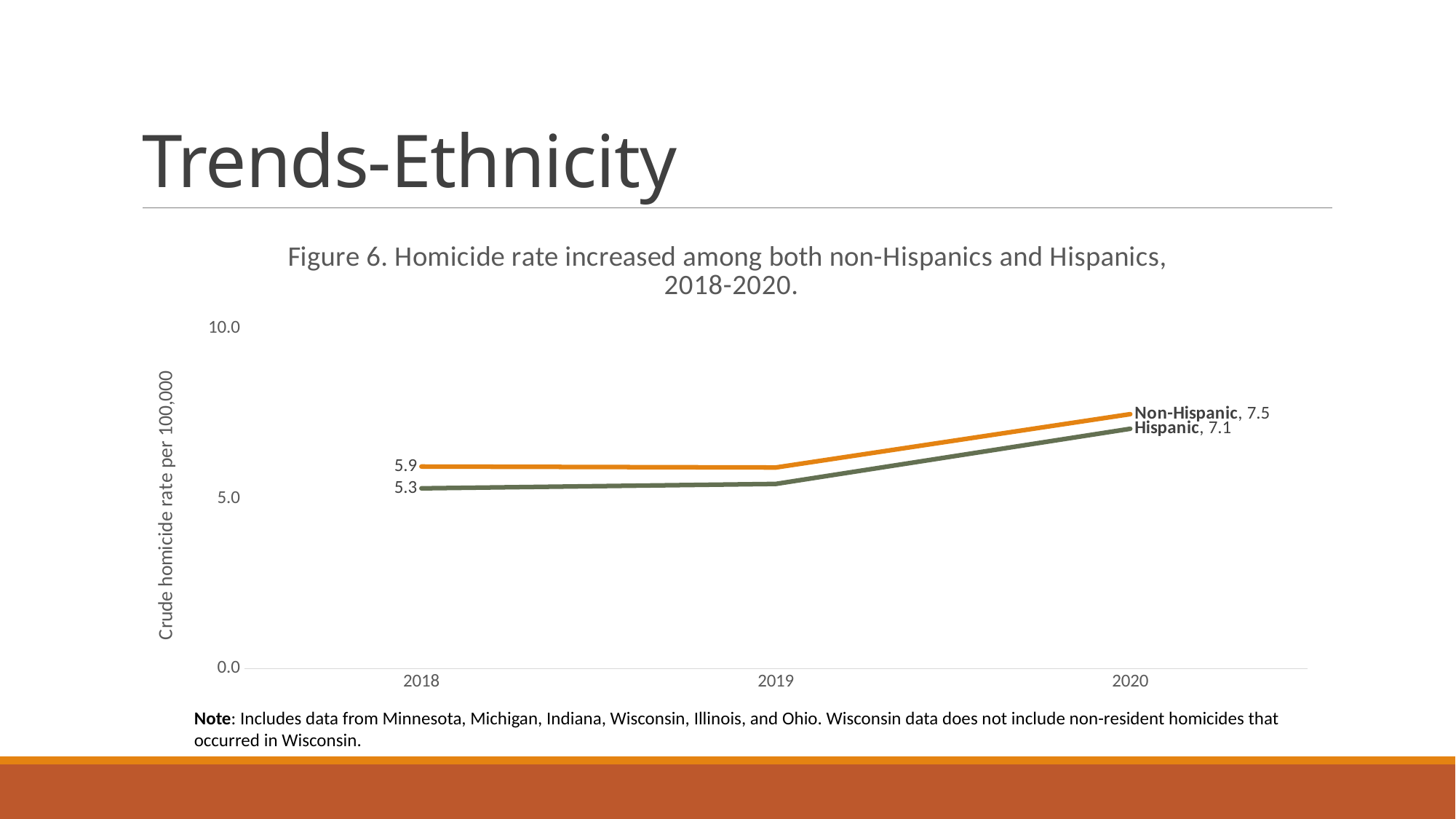
How many series are plotted in the chart? 2 What is the label of the y axis? Crude homicide rate per 100,000 By how much did the Hispanic homicide rate increase from 2018 to 2020? 1.8 What is the homicide rate for Hispanics in 2018? 5.3 What is the homicide rate for Hispanics in 2020? 7.1 Is the Hispanic homicide rate in 2019 greater or less than 5.0? greater How many years are plotted on the x axis? 3 What is the homicide rate for Non-Hispanics in 2020? 7.5 Which group had the higher homicide rate in 2018, Non-Hispanic or Hispanic? Non-Hispanic What is the difference between the Non-Hispanic and Hispanic homicide rates in 2020? 0.4 What kind of chart is shown on the slide? Line chart What is the homicide rate for Non-Hispanics in 2018? 5.9